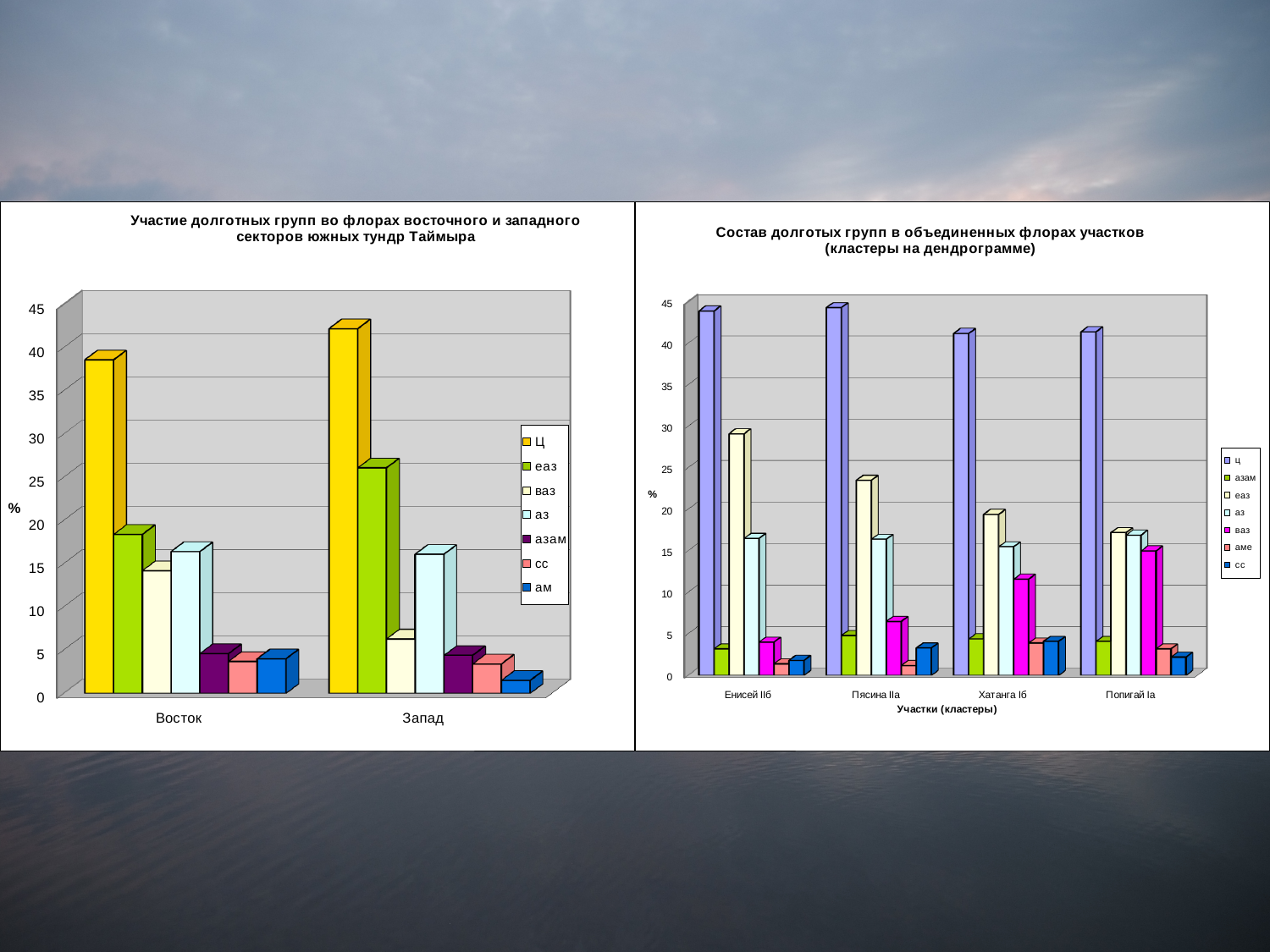
In the right chart, is the value of ц for Енисей IIб greater or less than 40? greater In the right chart, do the values of the еаз series rise or fall from Енисей IIб to Попигай Iа? fall In the left chart, which series has the highest value for Восток? Ц What is the x-axis title of the right chart, "Состав долготых групп в объединенных флорах участков"? Участки (кластеры) How many series does the legend of the right chart, "Состав долготых групп в объединенных флорах участков", list? 7 In the right chart, is the value of еаз for Енисей IIб greater or less than 25? greater What kind of chart is the left chart, titled "Участие долготных групп во флорах восточного и западного секторов южных тундр Таймыра"? bar chart In the left chart, which is larger: the value of ц for Запад or the value of ц for Восток? Запад How many categories are shown on the x axis of the left chart, "Участие долготных групп во флорах восточного и западного секторов южных тундр Таймыра"? 2 In the left chart, is the value of еаз for Восток greater or less than 20? less How many categories are shown on the x axis of the right chart, "Состав долготых групп в объединенных флорах участков"? 4